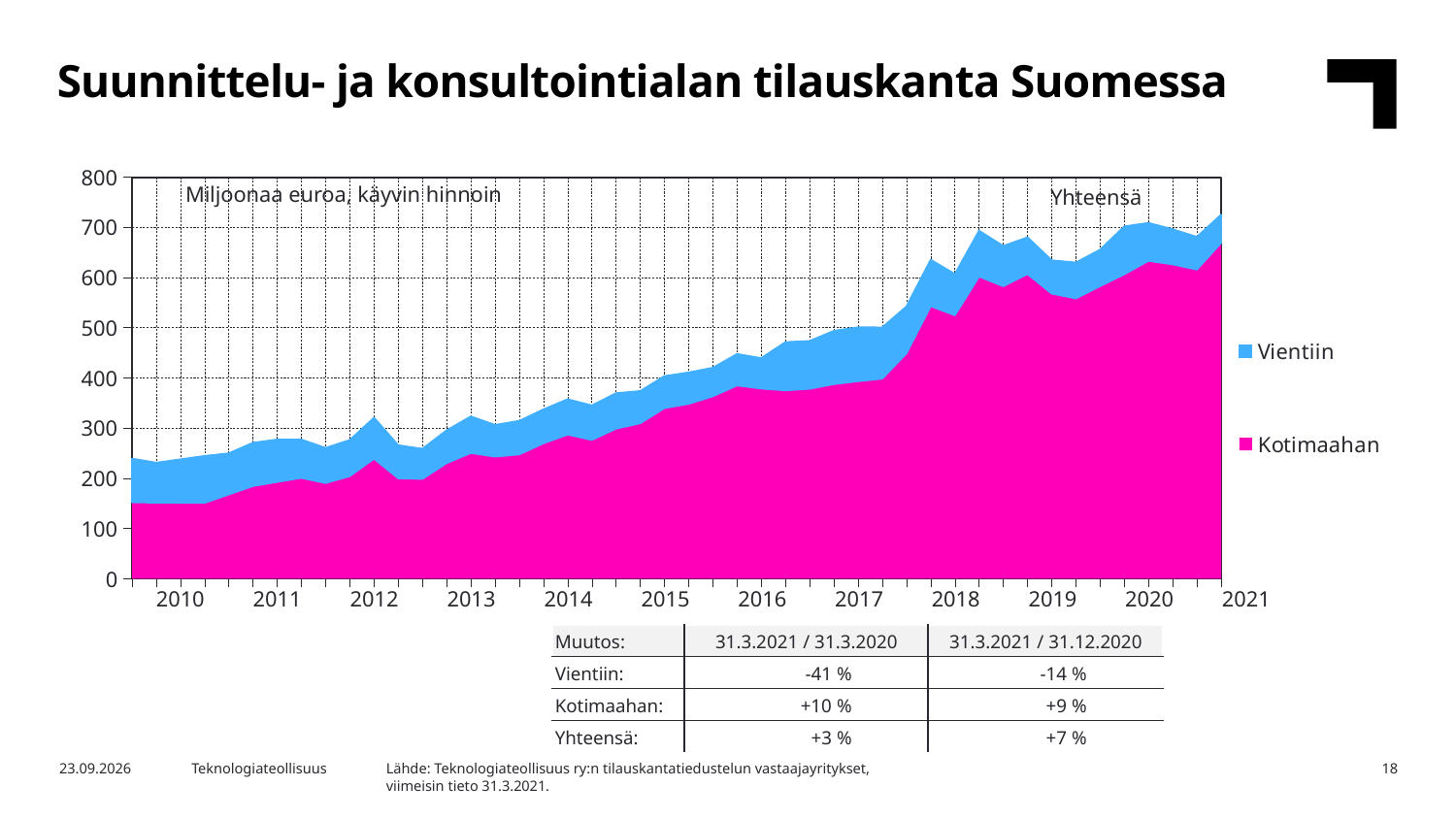
What kind of chart is shown on the slide? Stacked area chart What unit is stated in the chart's label at the top left of the plot area? Miljoonaa euroa, käyvin hinnoin Is the total (Yhteensä) value at the start of 2010 greater or less than 300? less Is the Kotimaahan value at the end of the series in 2021 greater or less than 500? greater How many series does the chart legend list? 2 Which two series are listed in the chart legend? Vientiin and Kotimaahan Is the total (Yhteensä) value in 2014 greater or less than 500? less Overall, does the total order backlog (Yhteensä) rise or fall from 2010 to 2021? Rise What is the highest value shown on the vertical axis of the chart? 800 Which series accounts for the larger part of the total backlog throughout the chart, Vientiin or Kotimaahan? Kotimaahan